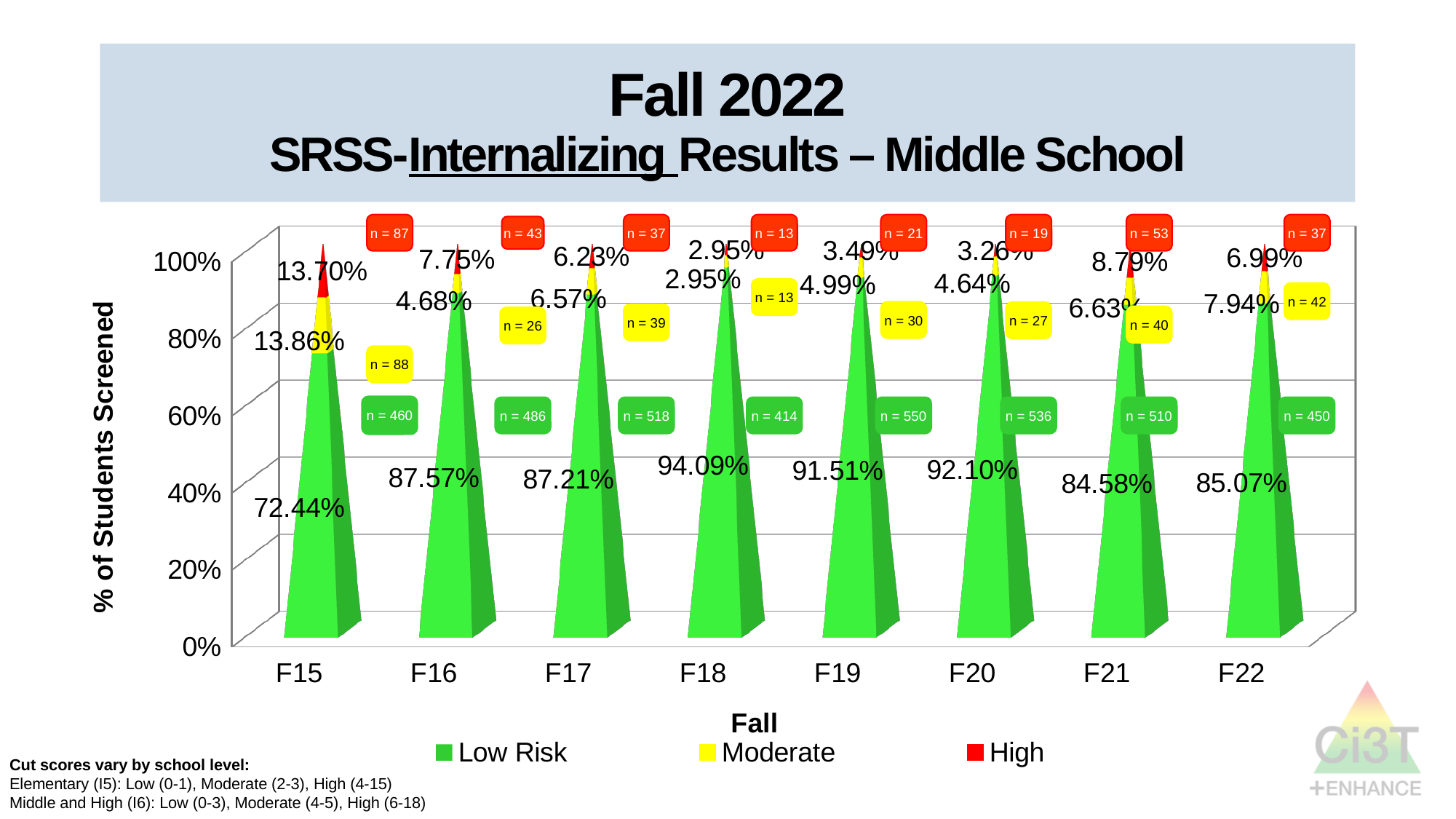
What is the title of the y axis? % of Students Screened How many series does the legend list? 3 What is the High percentage for F15? 13.70% Which fall has the lowest Low Risk percentage? F15 What is the Low Risk percentage for F22? 85.07% What kind of chart is shown on the slide? Stacked bar chart What is the difference between the Low Risk percentages for F16 and F15? 15.13 percentage points Which has a larger High percentage, F21 or F22? F21 What is the Low Risk percentage for F18? 94.09% What is the Moderate percentage for F15? 13.86% How many fall screening periods are shown on the x axis? 8 Which fall has the highest Low Risk percentage? F18